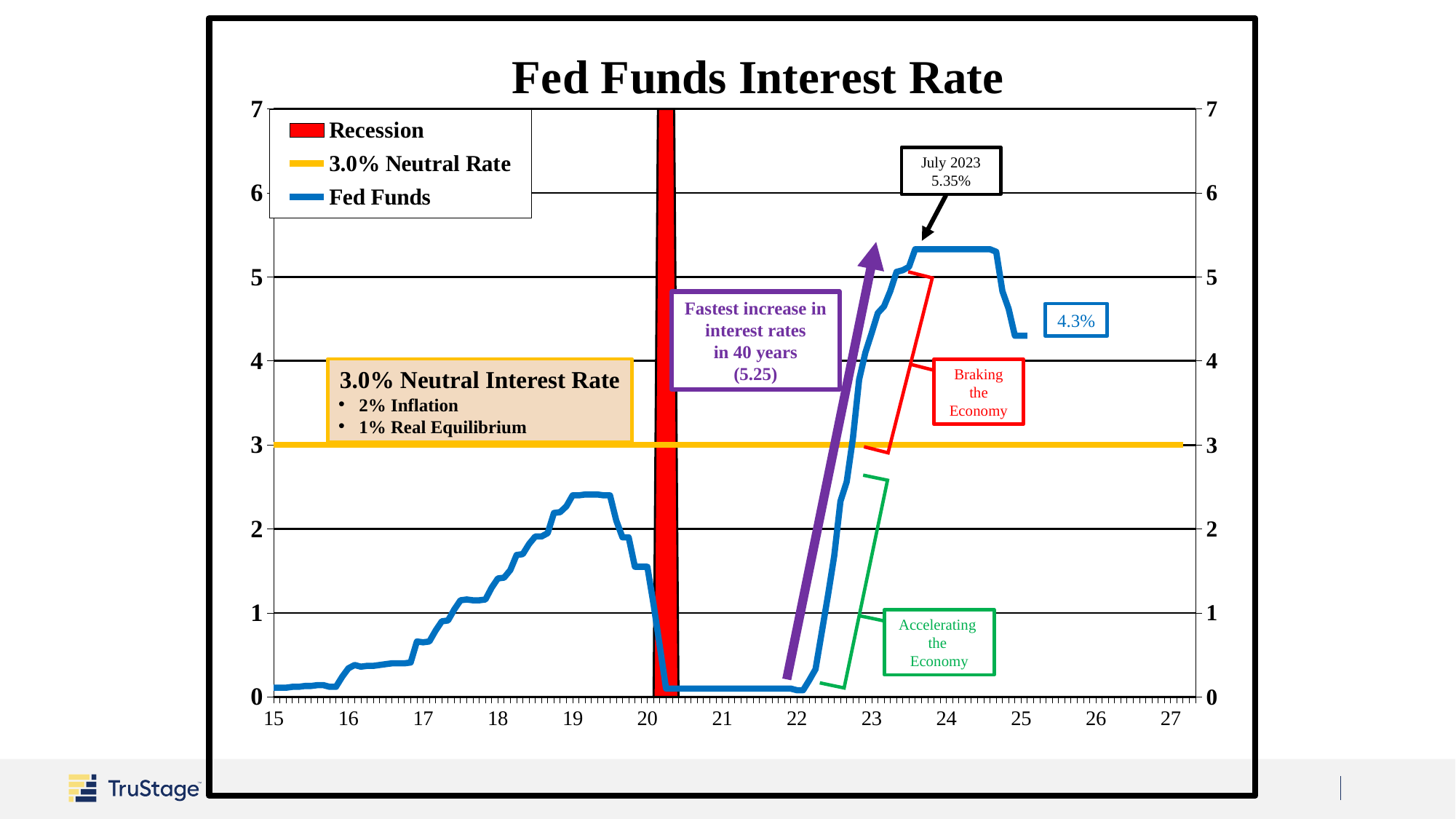
Is the Fed Funds rate at its 2019 peak greater or less than 2? greater What is the title of the chart? Fed Funds Interest Rate Does the Fed Funds line rise or fall between 2022 and 2023? rises Which is larger, the Fed Funds rate labelled for July 2023 or the rate labelled at the end of the line? July 2023 (5.35%) Is the Fed Funds rate during 2021 greater or less than 1? less How many entries does the chart's legend list? 3 What kind of chart is shown on the slide? line chart What is the neutral interest rate shown by the yellow horizontal line? 3.0% What value is labelled at the end of the Fed Funds line, around 2025? 4.3% What is the difference between the July 2023 rate of 5.35% and the later labelled rate of 4.3%? 1.05 percentage points What Fed Funds rate is labelled for July 2023? 5.35% What colour is used for the Recession marker in the legend? red